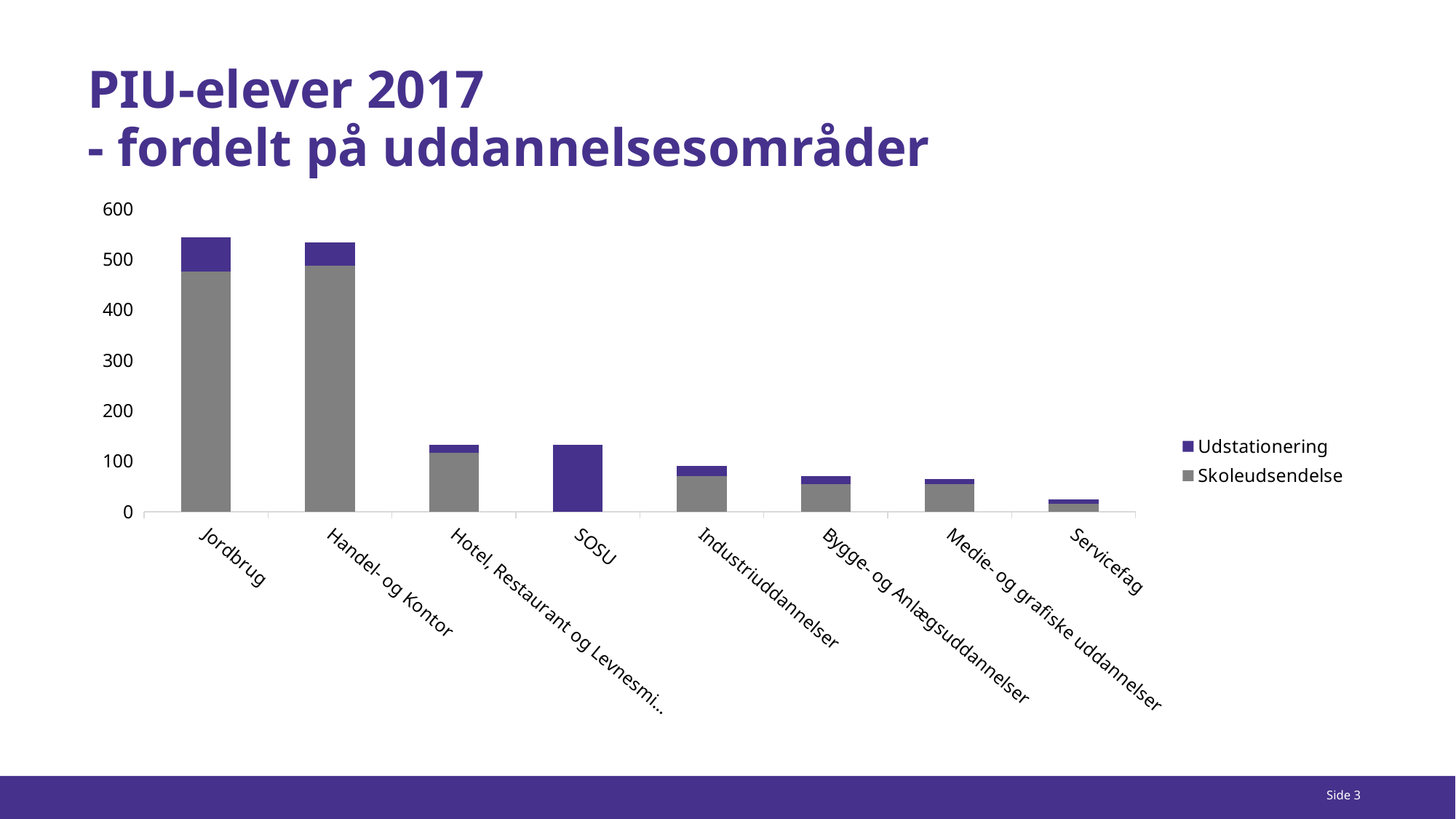
Which series is shown in purple in the chart's legend? Udstationering What kind of chart is shown on the slide? Stacked bar chart Which has the larger total bar, Jordbrug or SOSU? Jordbrug Is the total value for Jordbrug greater or less than 500? greater How many categories are shown on the x axis of the chart? 8 Do the total bar values generally rise or fall from left to right along the x axis? Fall Which has the larger total bar, Handel- og Kontor or Servicefag? Handel- og Kontor Is the total value for Servicefag greater or less than 100? less Which category has the lowest total bar in the chart? Servicefag How many series does the chart's legend list? 2 Is the value for SOSU greater or less than 100? greater